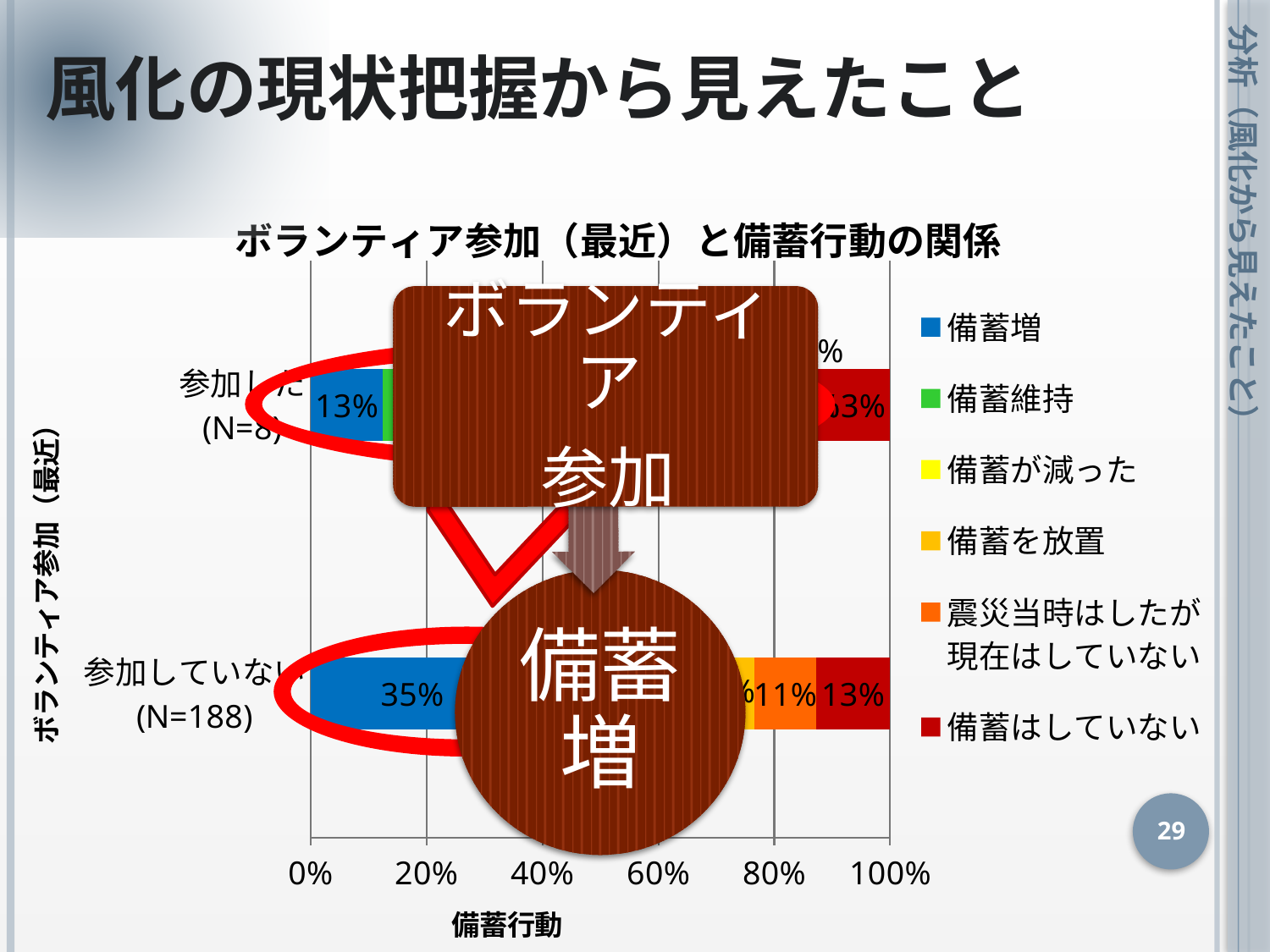
Which colour represents 備蓄増 in the legend? blue What is the 備蓄はしていない value for 参加していない (N=188)? 13% Which category has the larger 備蓄増 share, 参加した (N=8) or 参加していない (N=188)? 参加していない (N=188) What is the difference in 備蓄増 between 参加していない (N=188) and 参加した (N=8)? 22 percentage points What is the title of the chart? ボランティア参加（最近）と備蓄行動の関係 What is the 備蓄増 value for 参加した (N=8)? 13% How many categories are plotted on the vertical axis of the chart? 2 What is the 備蓄増 value for 参加していない (N=188)? 35% What kind of chart is shown on the slide? stacked bar chart Is the 備蓄増 value for 参加していない (N=188) greater or less than 20%? greater How many series does the chart legend list? 6